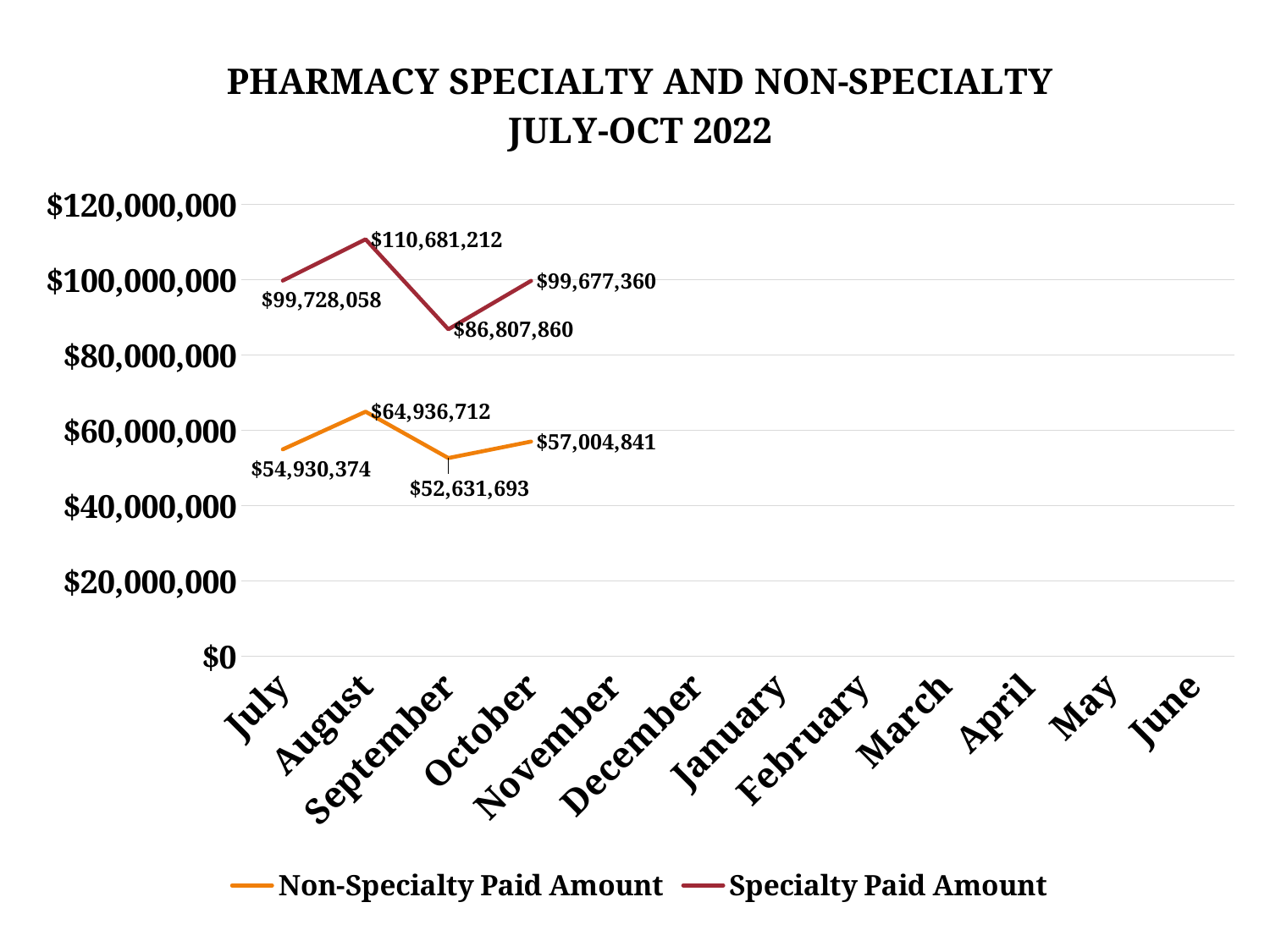
What kind of chart is shown on the slide? Line chart How much higher is the Non-Specialty Paid Amount in August than in September? $12,305,019 What is the Non-Specialty Paid Amount for October? $57,004,841 Which is larger, the Specialty Paid Amount in July or in October? July What is the difference between the Specialty Paid Amount and the Non-Specialty Paid Amount in August? $45,744,500 Is the Specialty Paid Amount for September greater or less than $80,000,000? greater In which month is the Specialty Paid Amount highest? August How many months are labelled on the x axis? 12 In which month is the Non-Specialty Paid Amount lowest? September What is the Specialty Paid Amount for August? $110,681,212 What is the Non-Specialty Paid Amount for September? $52,631,693 How many series does the legend list? 2